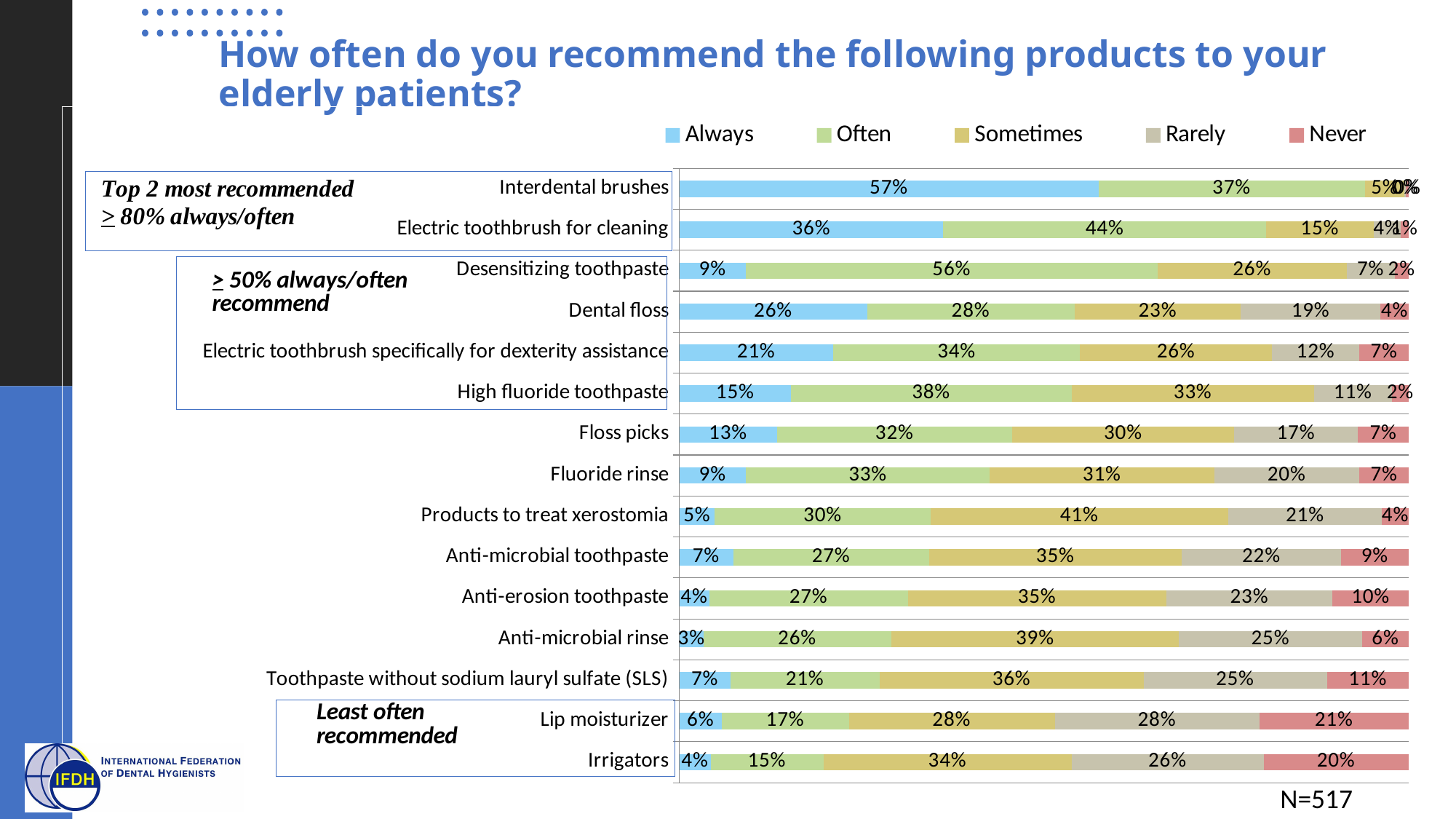
What is the 'Sometimes' value for Products to treat xerostomia? 41% What is the difference between the 'Often' and 'Always' values for Dental floss? 2 percentage points What is the 'Often' value for Desensitizing toothpaste? 56% Which product has the highest 'Often' percentage? Desensitizing toothpaste Which product has the highest 'Always' percentage? Interdental brushes What percentage 'Never' recommend Lip moisturizer? 21% Which product has the lowest 'Always' percentage? Anti-microbial rinse How many products are listed in the chart? 15 Which is larger: the 'Never' value for Irrigators or the 'Never' value for Dental floss? Irrigators What percentage of respondents said they 'Always' recommend interdental brushes? 57% How many series does the legend list? 5 What kind of chart is shown on the slide? Stacked bar chart